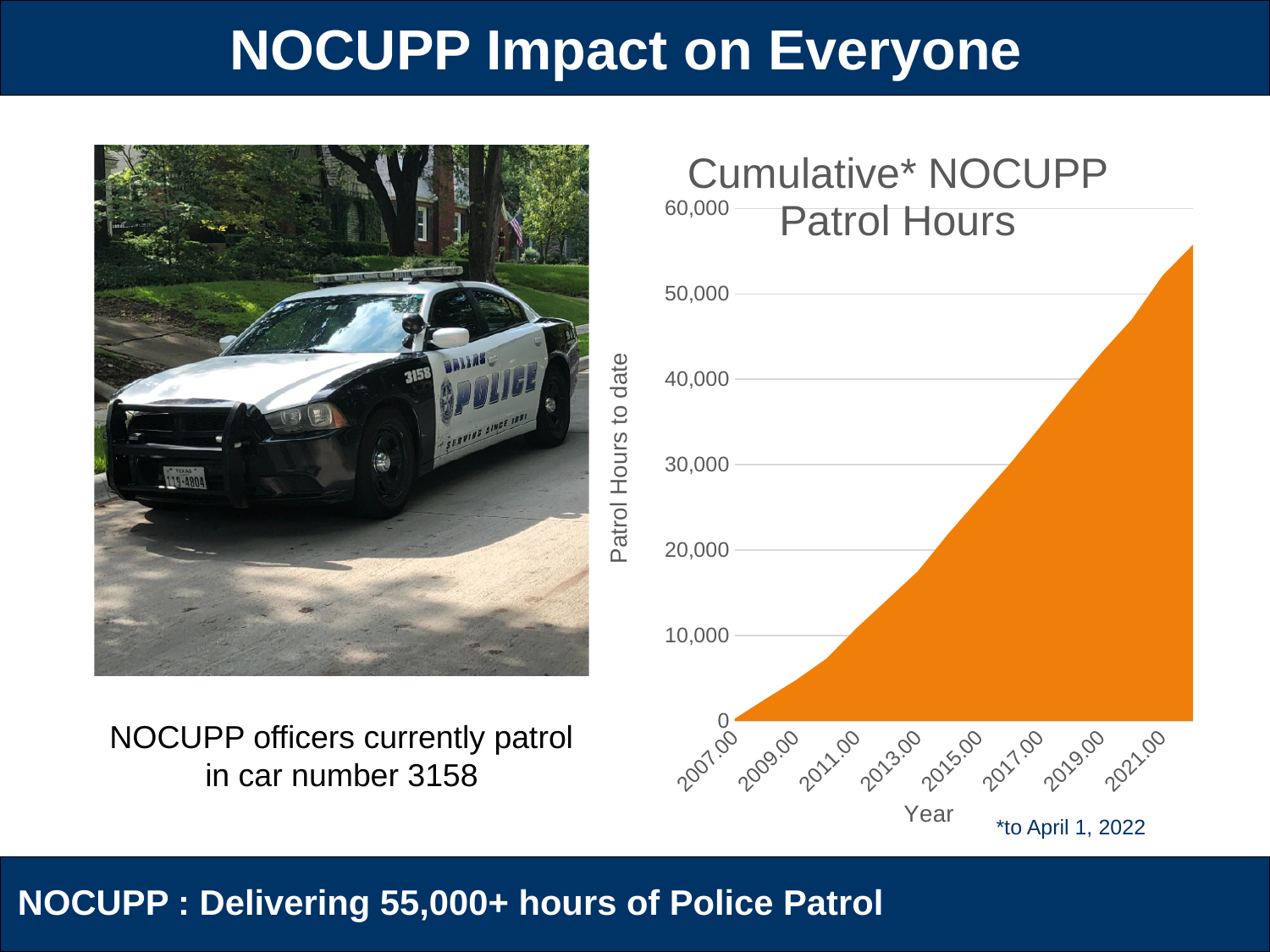
Which has more cumulative patrol hours, 2009.00 or 2019.00? 2019.00 What kind of chart is shown on the slide? Area chart Is the value for 2015.00 greater or less than 20,000? greater How many year tick labels are shown on the x axis of the chart? 8 Is the value for 2017.00 greater or less than 30,000? greater Is the value for 2013.00 greater or less than 20,000? less What is the label of the vertical axis of the chart? Patrol Hours to date What is the title of the chart? Cumulative* NOCUPP Patrol Hours Do the cumulative patrol hours rise or fall as the years increase along the x axis? Rise Which year tick on the x axis has the lowest cumulative patrol hours? 2007.00